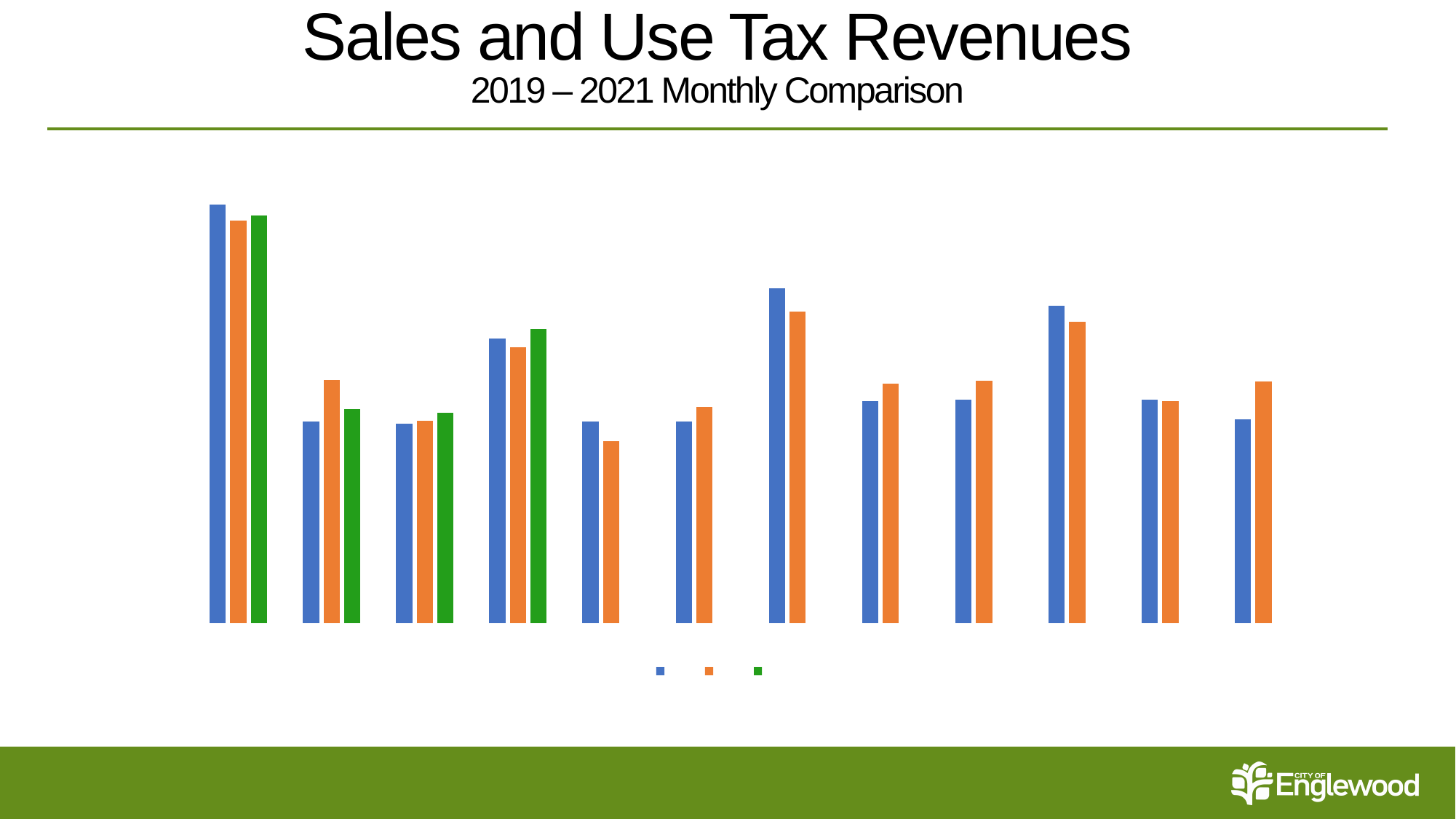
How many groups of bars include a green bar? 4 How many series does the legend show? 3 What kind of chart is shown on the slide? bar chart In the fourth group of bars from the left, which is taller, the green bar or the orange bar? the green bar What subtitle appears under the chart title? 2019 – 2021 Monthly Comparison In the leftmost group of bars, which is taller, the blue bar or the orange bar? the blue bar What is the title of the chart on the slide? Sales and Use Tax Revenues How many groups of bars are plotted along the x axis? 12 Which group of bars contains the tallest bar on the chart? the leftmost (first) group